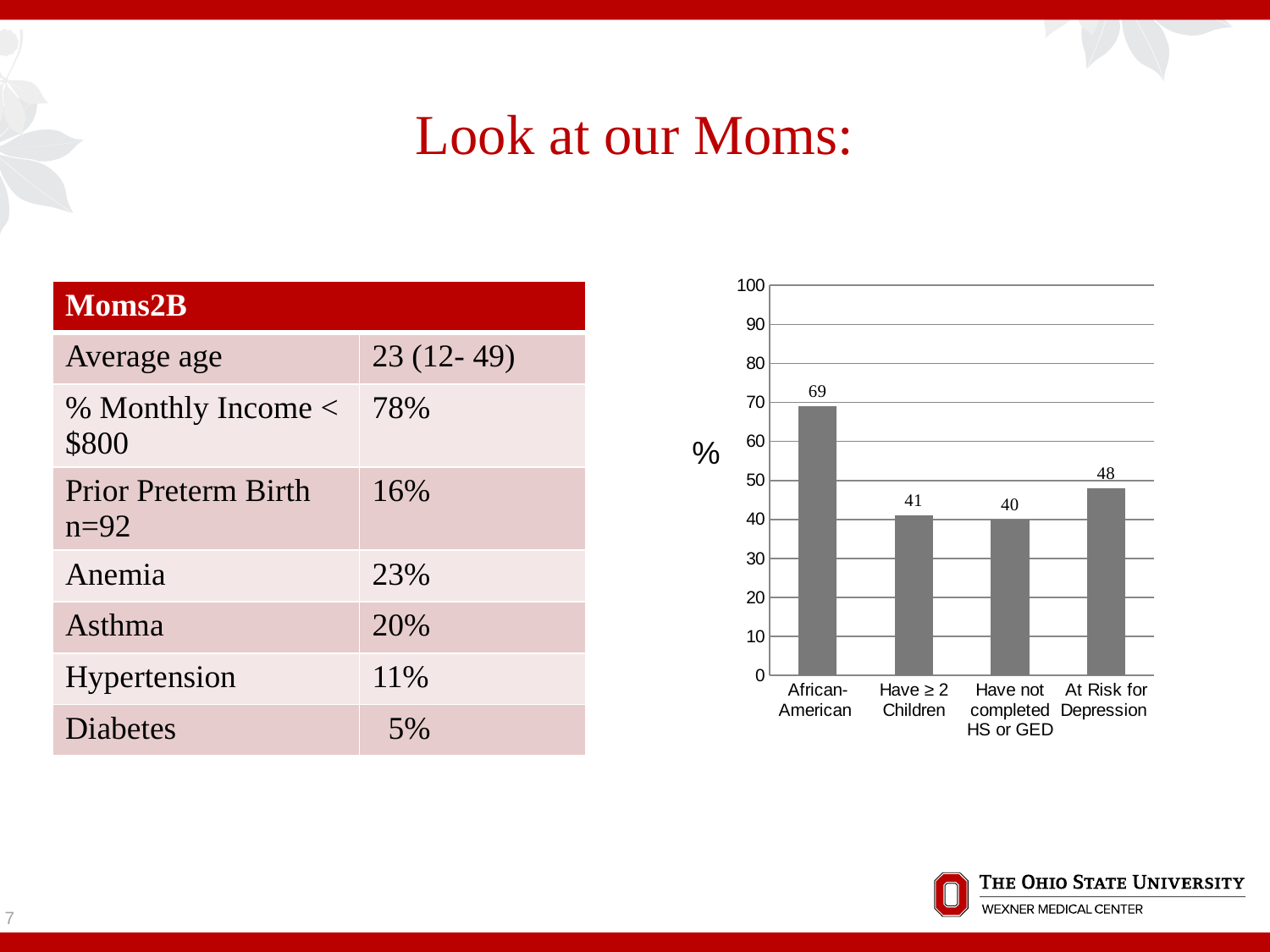
Is the value for African-American greater or less than 60? greater What is the value for At Risk for Depression in the bar chart? 48 Which is larger: the value for At Risk for Depression or the value for Have ≥ 2 Children? At Risk for Depression How many categories are shown in the bar chart? 4 What is the difference between the values for African-American and At Risk for Depression? 21 What is the value for African-American in the bar chart? 69 What is the label on the vertical axis of the bar chart? % What kind of chart is shown on the slide? bar chart What is the value for Have not completed HS or GED in the bar chart? 40 Which category has the highest value in the bar chart? African-American Which category has the lowest value in the bar chart? Have not completed HS or GED What is the value for Have ≥ 2 Children in the bar chart? 41